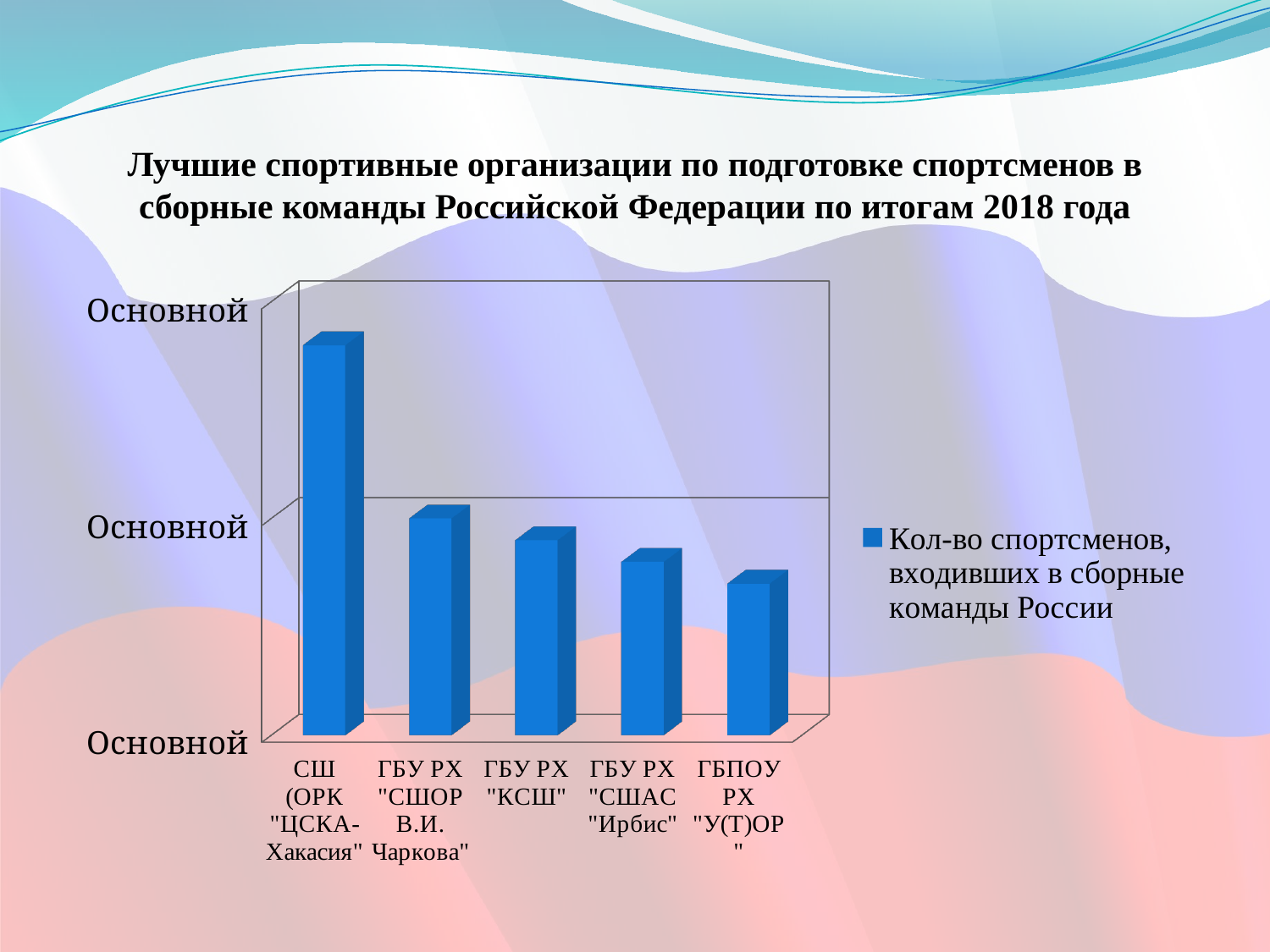
Which organisation has the highest bar in the chart? СШ (ОРК "ЦСКА-Хакасия" What is the name of the series shown in the chart legend? Кол-во спортсменов, входивших в сборные команды России Which organisation has the lowest bar in the chart? ГБПОУ РХ "У(Т)ОР" Which has the larger value: СШ (ОРК "ЦСКА-Хакасия" or ГБУ РХ "СШОР В.И. Чаркова"? СШ (ОРК "ЦСКА-Хакасия" What is the title of the chart on the slide? Лучшие спортивные организации по подготовке спортсменов в сборные команды Российской Федерации по итогам 2018 года How many series does the chart legend list? 1 Which has the larger value: ГБУ РХ "СШАС "Ирбис" or ГБПОУ РХ "У(Т)ОР"? ГБУ РХ "СШАС "Ирбис" Which has the larger value: ГБУ РХ "КСШ" or ГБУ РХ "СШОР В.И. Чаркова"? ГБУ РХ "СШОР В.И. Чаркова" How many organisations (categories) are plotted in the chart? 5 Do the bar values rise or fall from left to right along the x axis? Fall What kind of chart is shown on the slide? Bar chart